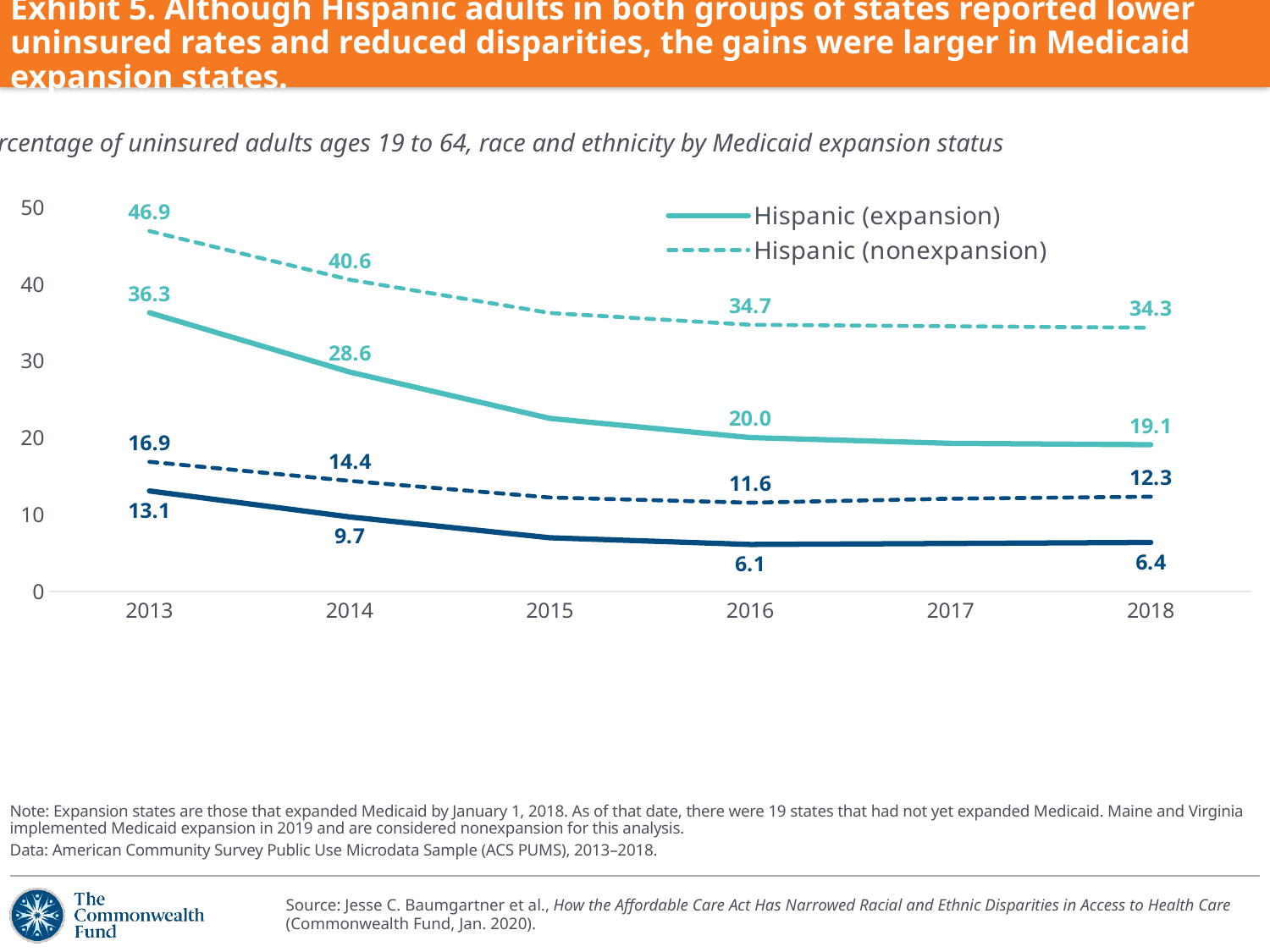
What was the uninsured rate for Hispanic (nonexpansion) in 2018? 34.3 In which year was the Hispanic (expansion) uninsured rate highest? 2013 What type of chart is shown on the slide? line chart What was the uninsured rate for Hispanic (expansion) in 2016? 20.0 Is the Hispanic (expansion) uninsured rate in 2015 greater or less than 20? greater What was the uninsured rate for Hispanic (expansion) in 2013? 36.3 How many years are shown on the x axis? 6 In which labeled year was the Hispanic (nonexpansion) uninsured rate lowest? 2018 What was the uninsured rate for Hispanic (nonexpansion) in 2014? 40.6 How many series does the legend list? 2 Which series had the higher uninsured rate in 2013, Hispanic (expansion) or Hispanic (nonexpansion)? Hispanic (nonexpansion) What is the difference between the Hispanic (nonexpansion) and Hispanic (expansion) uninsured rates in 2018? 15.2